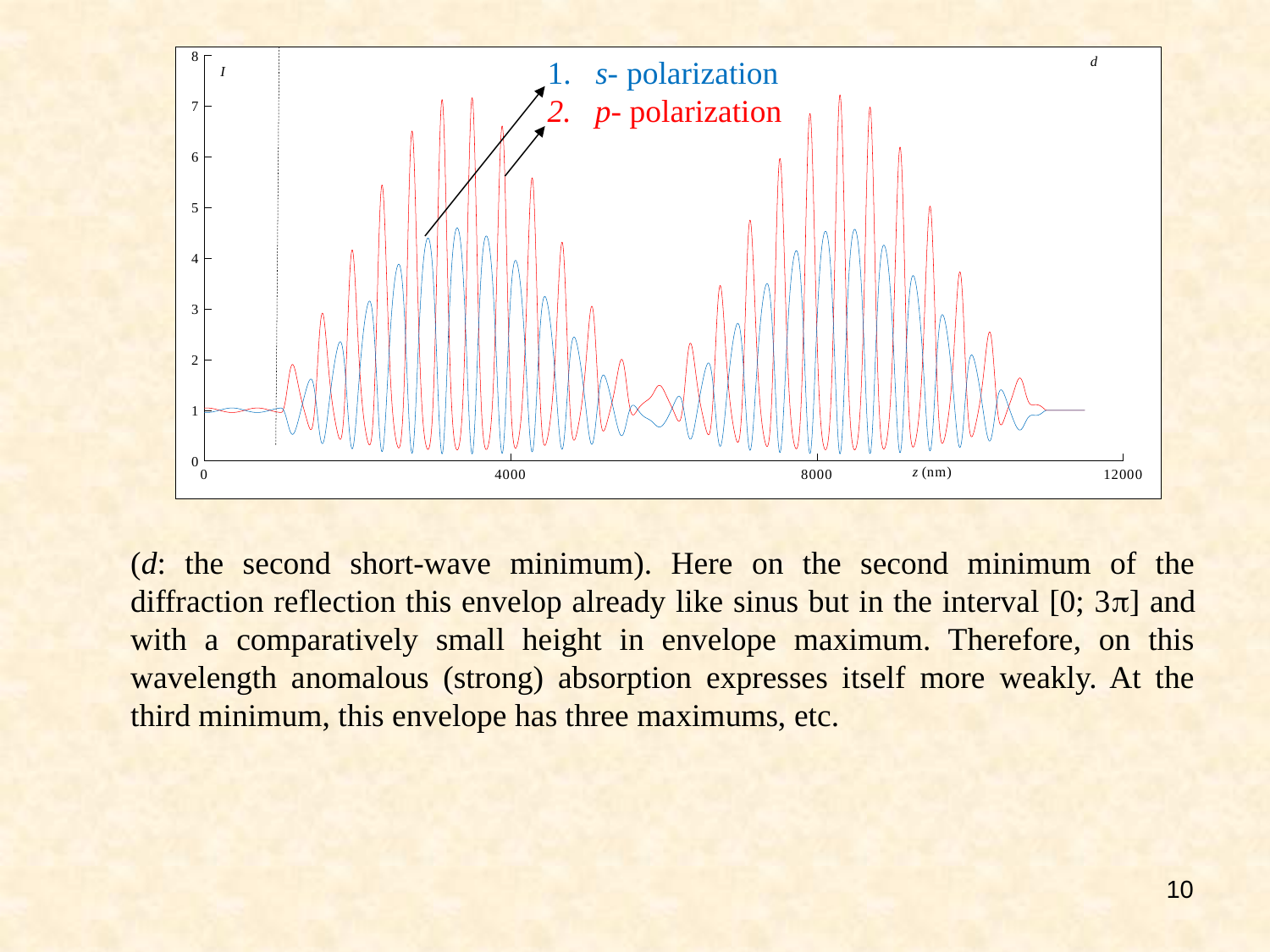
Which series is drawn in red? p- polarization What is the label of the y axis? I Is the value of both curves at z = 0 greater or less than 2? less Which series reaches higher peak values, s-polarization or p-polarization? p- polarization What kind of chart is shown on the slide? line chart Is the highest peak of the p-polarization curve greater or less than 6? greater Which series is drawn in blue? s- polarization Is the highest peak of the s-polarization curve greater or less than 5? less What is the maximum value shown on the y axis? 8 How many series are plotted on the chart? 2 What is the label of the x axis? z (nm) What is the maximum value shown on the x axis? 12000